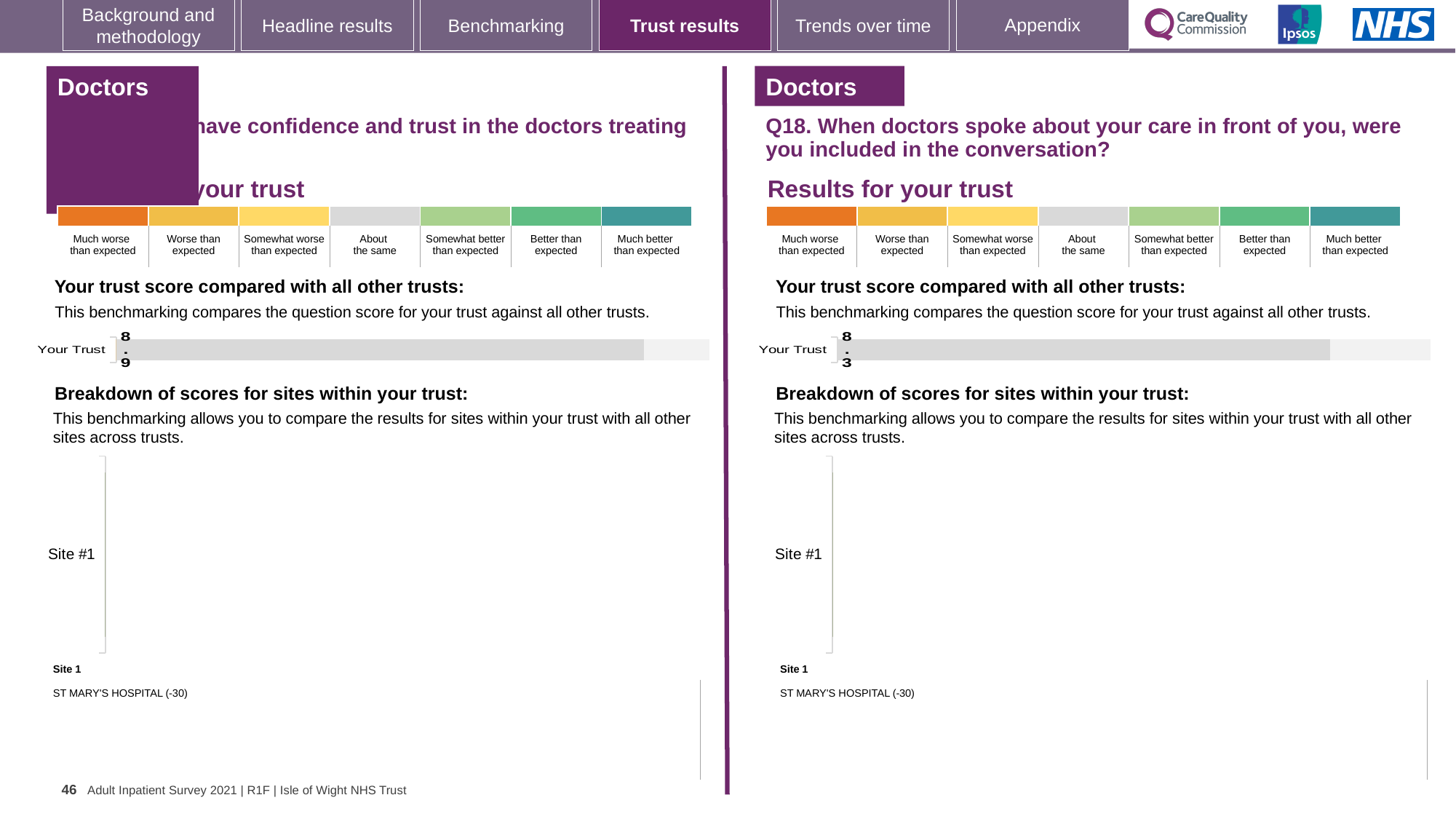
What is the difference between the Your Trust score on the left chart (8.9) and the Your Trust score on the right chart for Q18 (8.3)? 0.6 On the right chart for Q18 (When doctors spoke about your care in front of you, were you included in the conversation?), what is the score shown for Your Trust? 8.3 On the right chart for Q18, how many sites are listed in the breakdown of scores for sites within your trust? 1 On the left chart, what is the score shown for Your Trust? 8.9 What kind of chart is used to show the Your Trust score on the right chart for Q18? bar chart On the left chart, how many categories are plotted in the trust score comparison? 1 On the right chart for Q18, which site is listed as Site 1 in the breakdown of scores? ST MARY'S HOSPITAL (-30) Which chart shows the higher Your Trust score, the left chart or the right chart for Q18? the left chart On the left chart, how many rating categories are shown in the colour scale above the trust score comparison? 7